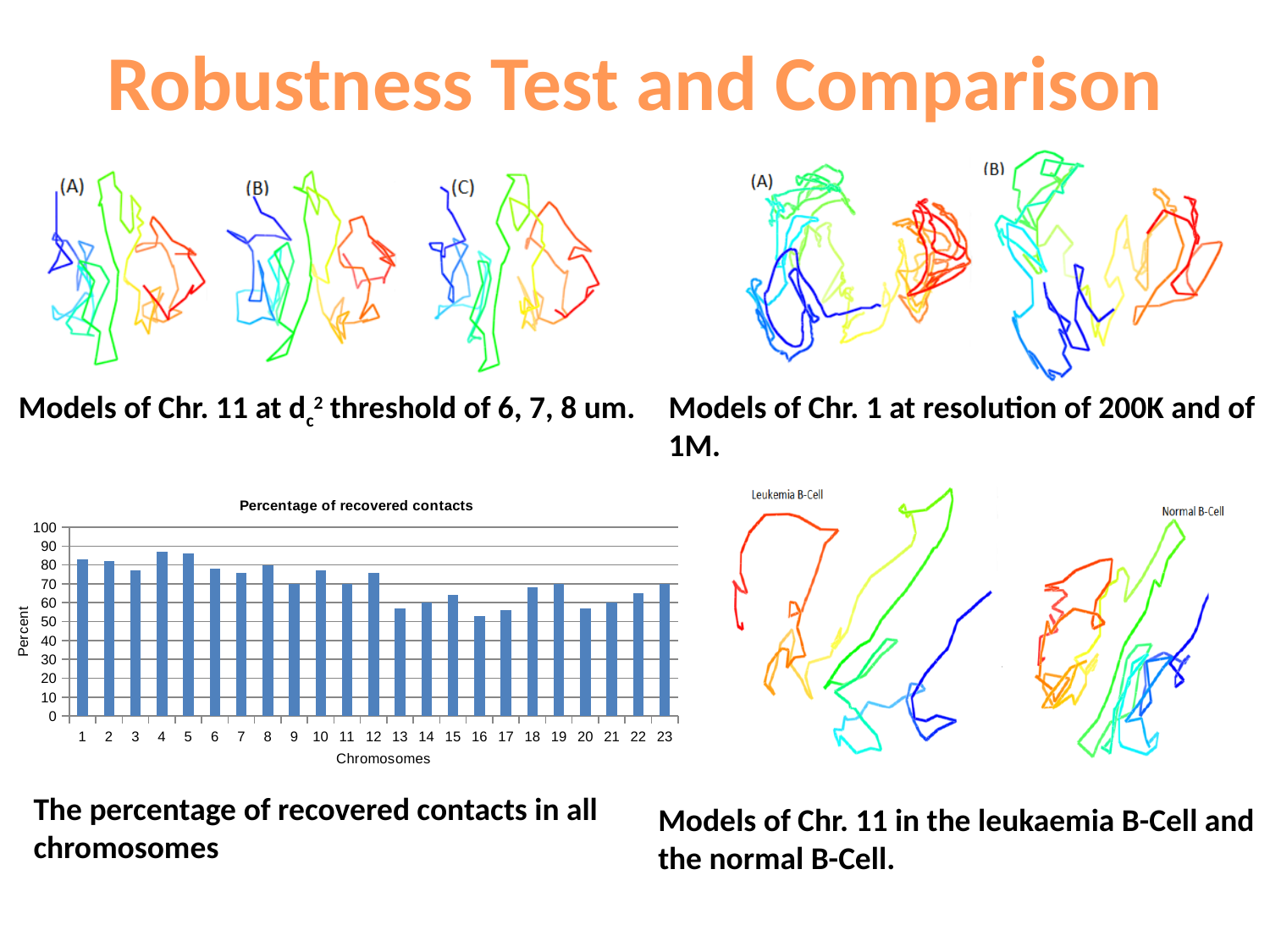
In the 'Percentage of recovered contacts' chart, is the value for chromosome 16 greater or less than 60? less In the 'Percentage of recovered contacts' chart, do the values generally rise or fall from chromosome 1 to chromosome 23? fall In the 'Percentage of recovered contacts' chart, is the value for chromosome 9 greater or less than 60? greater In the 'Percentage of recovered contacts' chart, is the value for chromosome 4 greater or less than 80? greater In the 'Percentage of recovered contacts' chart, which has the higher value, chromosome 1 or chromosome 16? chromosome 1 In the 'Percentage of recovered contacts' chart, which has the higher value, chromosome 20 or chromosome 8? chromosome 8 What is the label of the y axis on the 'Percentage of recovered contacts' chart? Percent How many chromosomes are shown on the x axis of the 'Percentage of recovered contacts' chart? 23 What is the label of the x axis on the 'Percentage of recovered contacts' chart? Chromosomes What kind of chart is the 'Percentage of recovered contacts' chart? bar chart